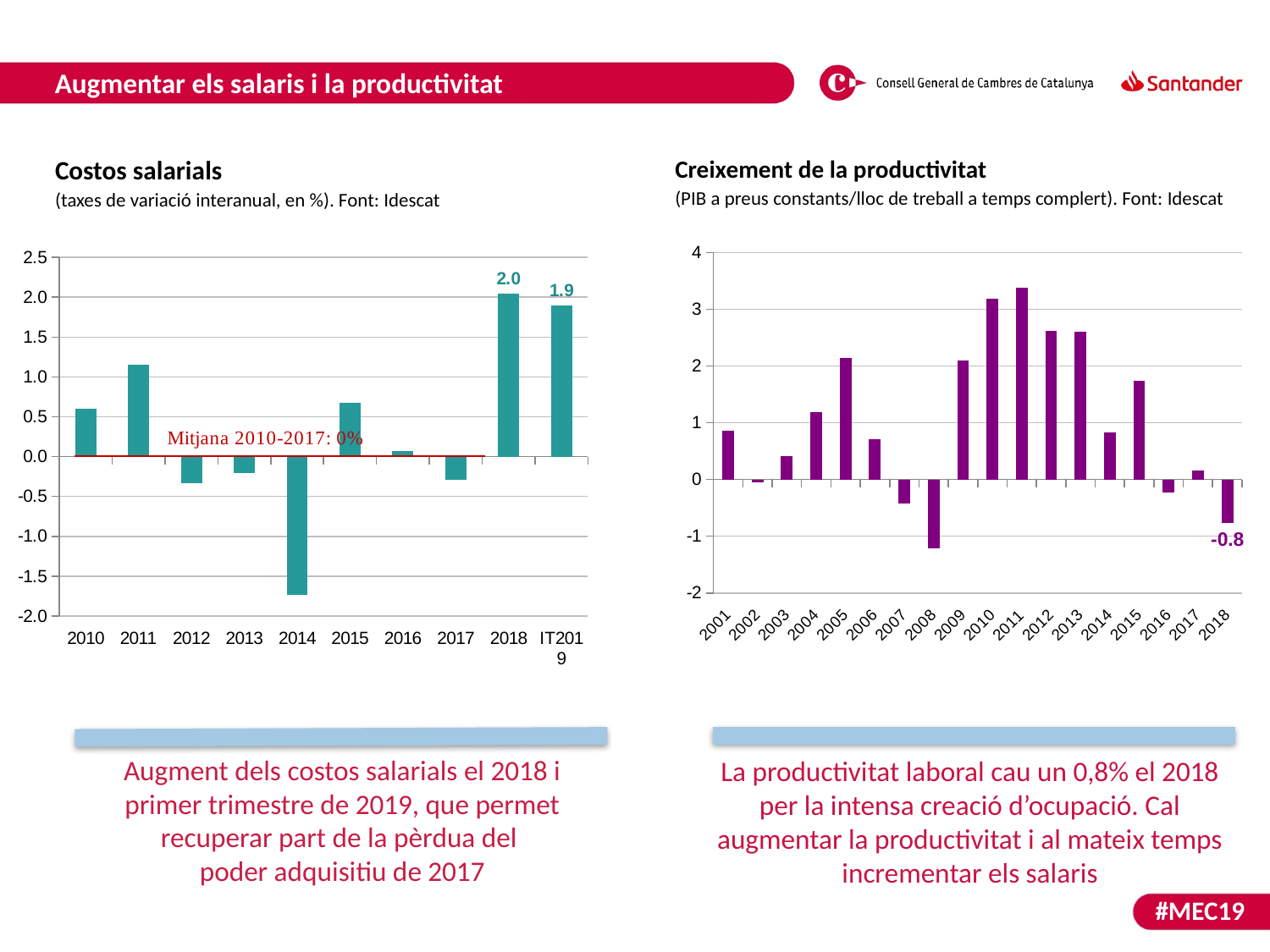
How many categories are shown on the x axis of the Costos salarials chart? 10 In the Costos salarials chart, is the value for 2011 greater or less than 1.0? greater What kind of chart is the Costos salarials chart? bar chart In the Costos salarials chart, what is the value for IT2019? 1.9 In the Costos salarials chart, what does the label on the red horizontal line say? Mitjana 2010-2017: 0% In the Costos salarials chart, which year has the lowest value? 2014 How many years are shown on the x axis of the Creixement de la productivitat chart? 18 In the Creixement de la productivitat chart, which year has the lowest value? 2008 In the Costos salarials chart, which category has the highest value? 2018 In the Costos salarials chart, what is the difference between the values for 2018 and IT2019? 0.1 In the Creixement de la productivitat chart, what is the value for 2018? -0.8 In the Costos salarials chart, what is the value for 2018? 2.0